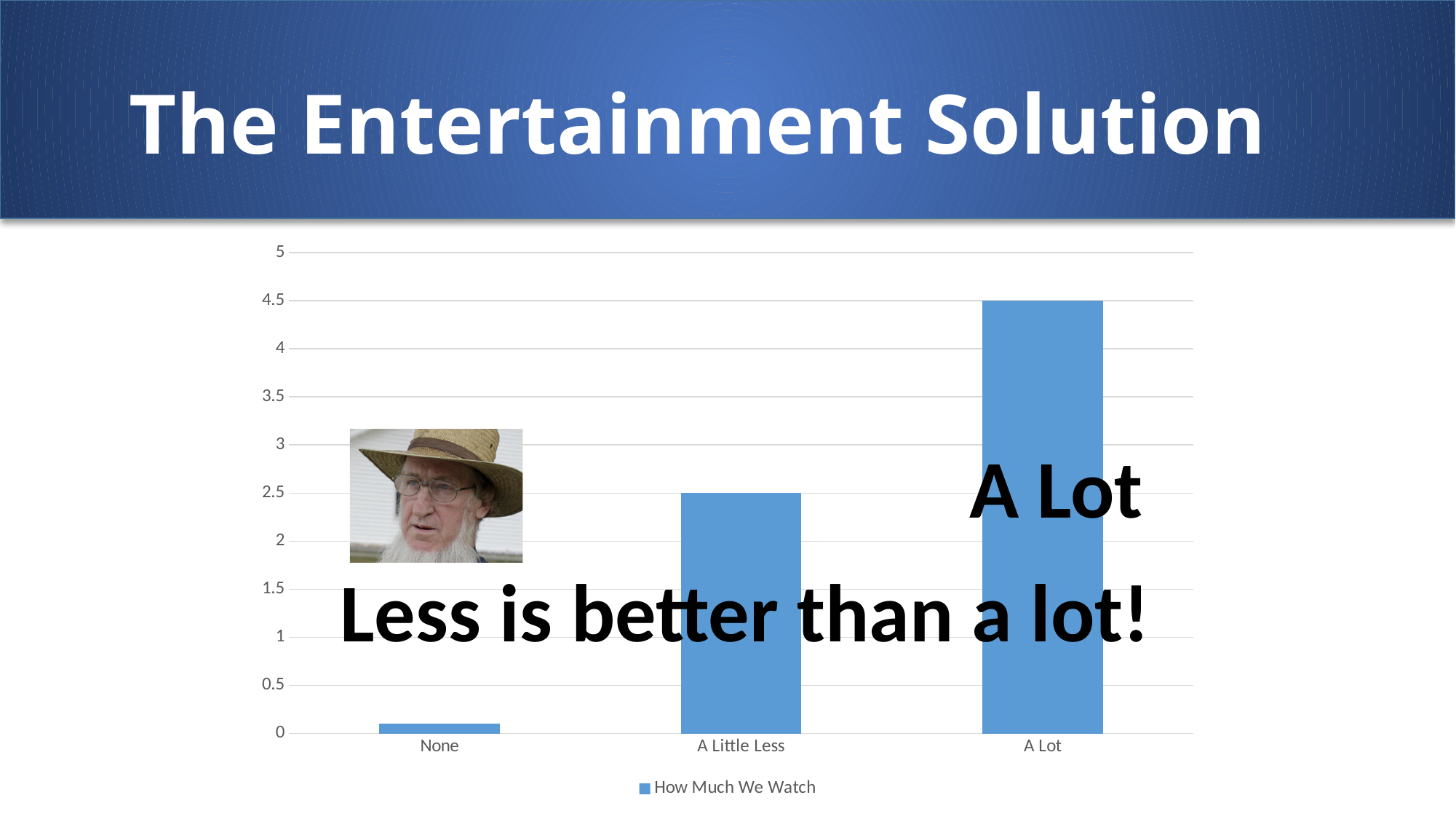
Which category has the lowest value in the chart? None How many categories are shown on the x axis of the chart? 3 What is the name of the series in the chart's legend? How Much We Watch Is the value for 'None' greater or less than 0.5? less Which is larger, the value for 'A Little Less' or the value for 'None'? A Little Less Which category has the highest value in the chart? A Lot What is the value for 'A Lot' in the chart? 4.5 What is the value for 'A Little Less' in the chart? 2.5 What is the difference between the values for 'A Lot' and 'A Little Less'? 2 Do the values rise or fall moving from 'None' to 'A Lot' along the x axis? rise What kind of chart is shown on the slide? bar chart How many series does the chart's legend list? 1